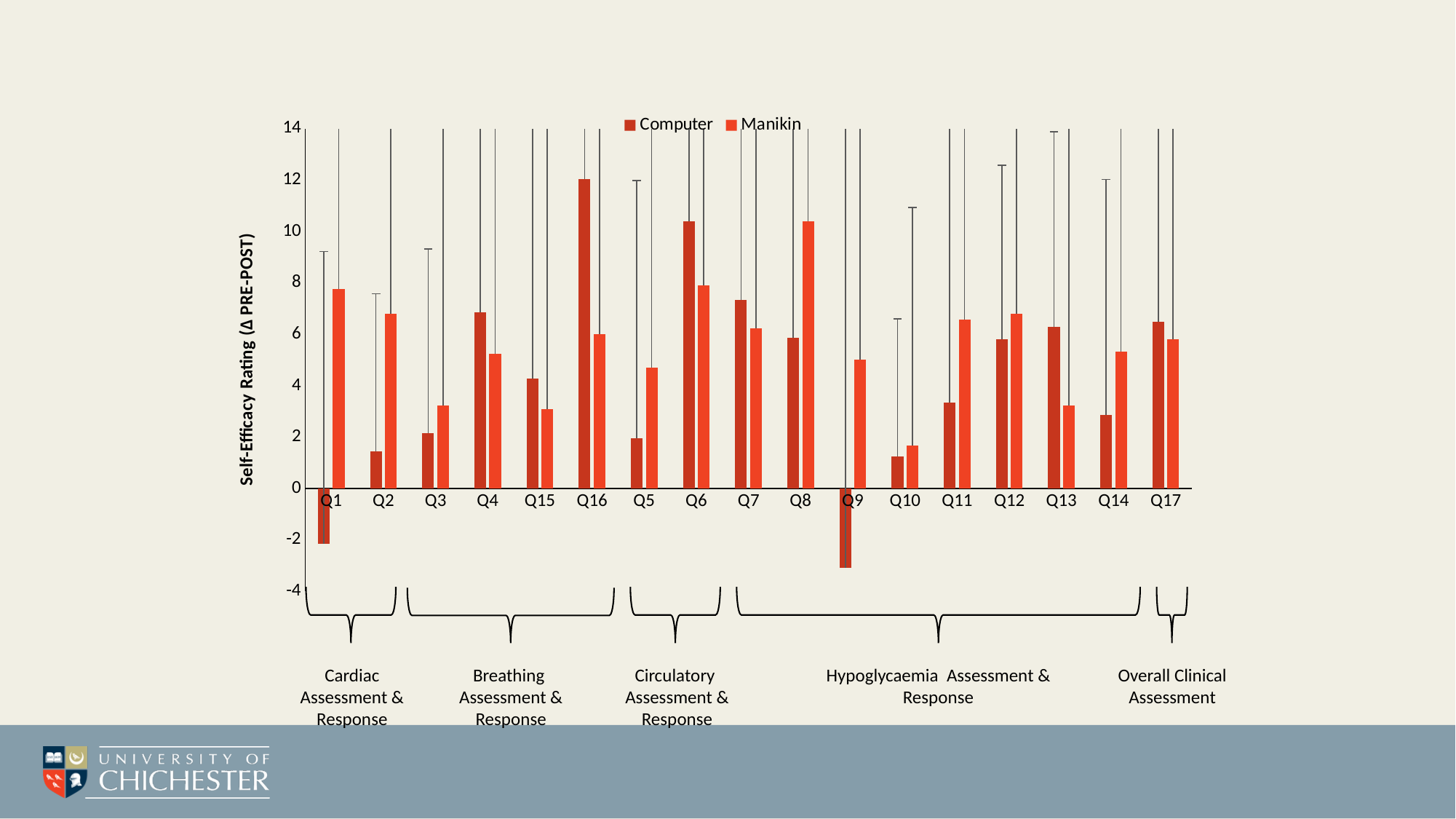
What kind of chart is shown on the slide? bar chart For Q1, which series has the larger value, Computer or Manikin? Manikin Is the Computer value for Q16 greater or less than 10? greater What is the title of the y axis? Self-Efficacy Rating (Δ PRE-POST) Is the Computer value for Q9 greater or less than 0? less How many question categories are plotted along the x axis? 17 Which category has the highest Manikin value? Q8 Which category has the lowest Manikin value? Q10 How many series does the legend list? 2 Which category has the highest Computer value? Q16 Which category has the lowest Computer value? Q9 For Q6, which series has the larger value, Computer or Manikin? Computer